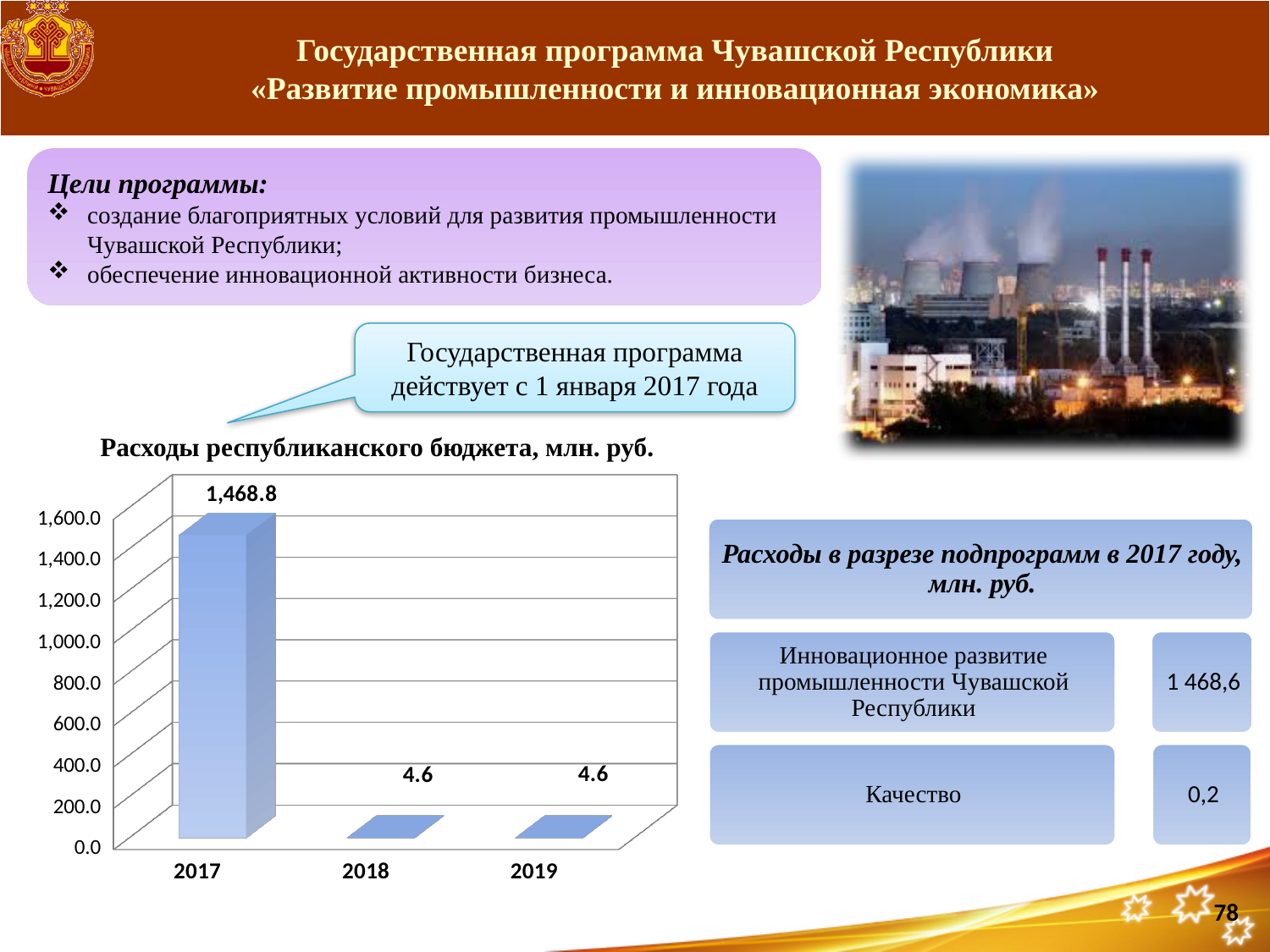
What is the value for 2017 in the chart 'Расходы республиканского бюджета, млн. руб.'? 1,468.8 Do the values rise or fall from 2017 to 2018? fall Is the value for 2018 greater or less than 200.0? less What is the title of the chart? Расходы республиканского бюджета, млн. руб. What is the difference between the values for 2017 and 2018? 1,464.2 What kind of chart is shown on the slide? bar chart How many years are shown on the x axis of the chart? 3 What is the value for 2018 in the chart? 4.6 Which is larger, the value for 2017 or the value for 2019? 2017 What is the value for 2019 in the chart? 4.6 Which year has the highest value in the chart? 2017 Is the value for 2017 greater or less than 1,400.0? greater